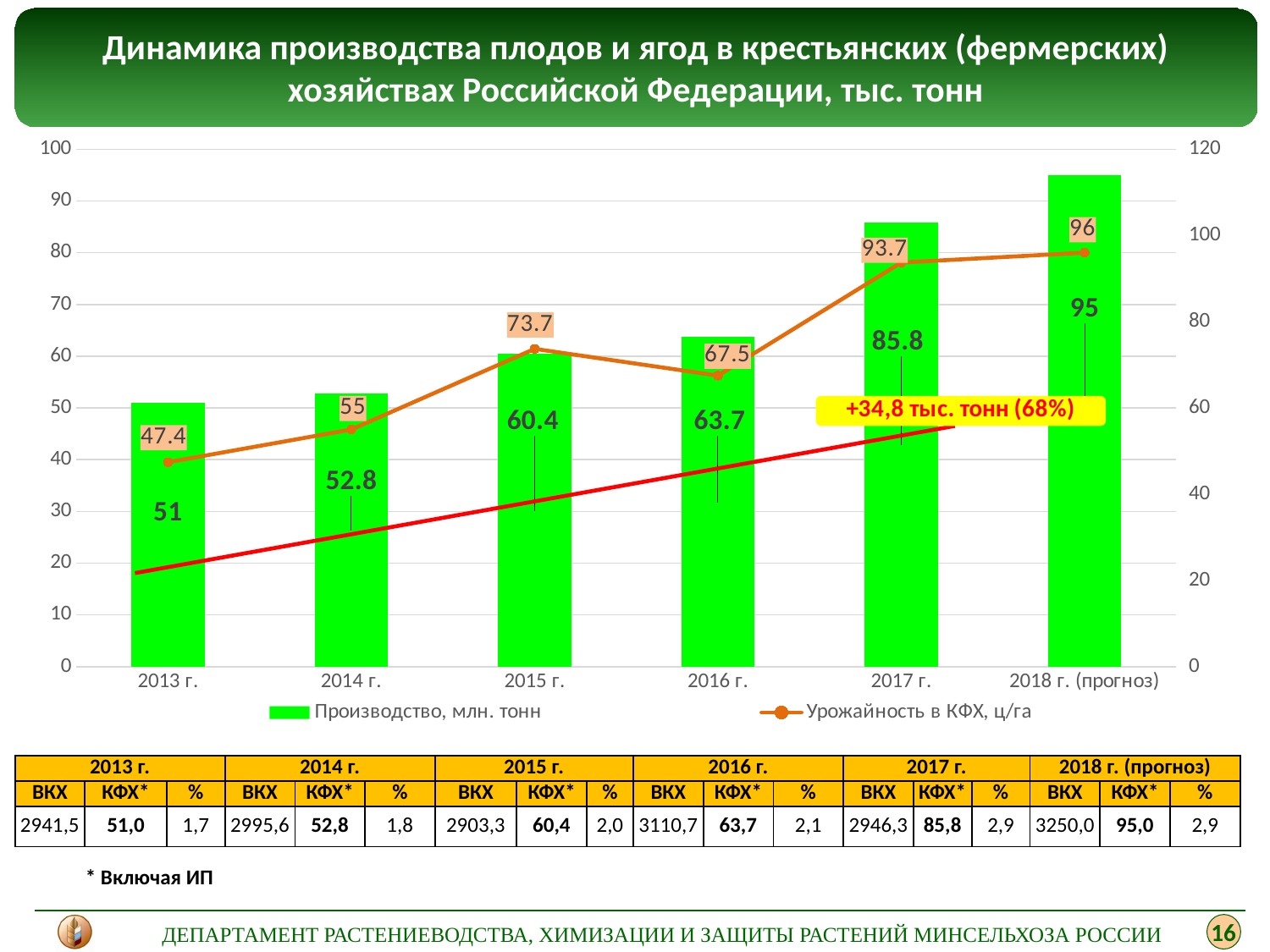
How many series does the chart legend list? 2 Which year has the highest value of Производство, млн. тонн? 2018 г. (прогноз) What is the value of Урожайность в КФХ, ц/га for 2017 г.? 93.7 What colour are the bars for Производство, млн. тонн? green What is the value of Производство, млн. тонн for 2015 г.? 60.4 Does Производство, млн. тонн rise or fall from 2013 г. to 2018 г. (прогноз)? rise What is the value of Производство, млн. тонн for 2018 г. (прогноз)? 95 How many years are shown on the x axis of the chart? 6 Which is larger, Урожайность в КФХ, ц/га in 2015 г. or in 2016 г.? 2015 г. What is the value of Урожайность в КФХ, ц/га for 2013 г.? 47.4 What is the difference in Производство, млн. тонн between 2017 г. and 2016 г.? 22.1 Which year has the lowest value of Урожайность в КФХ, ц/га? 2013 г.